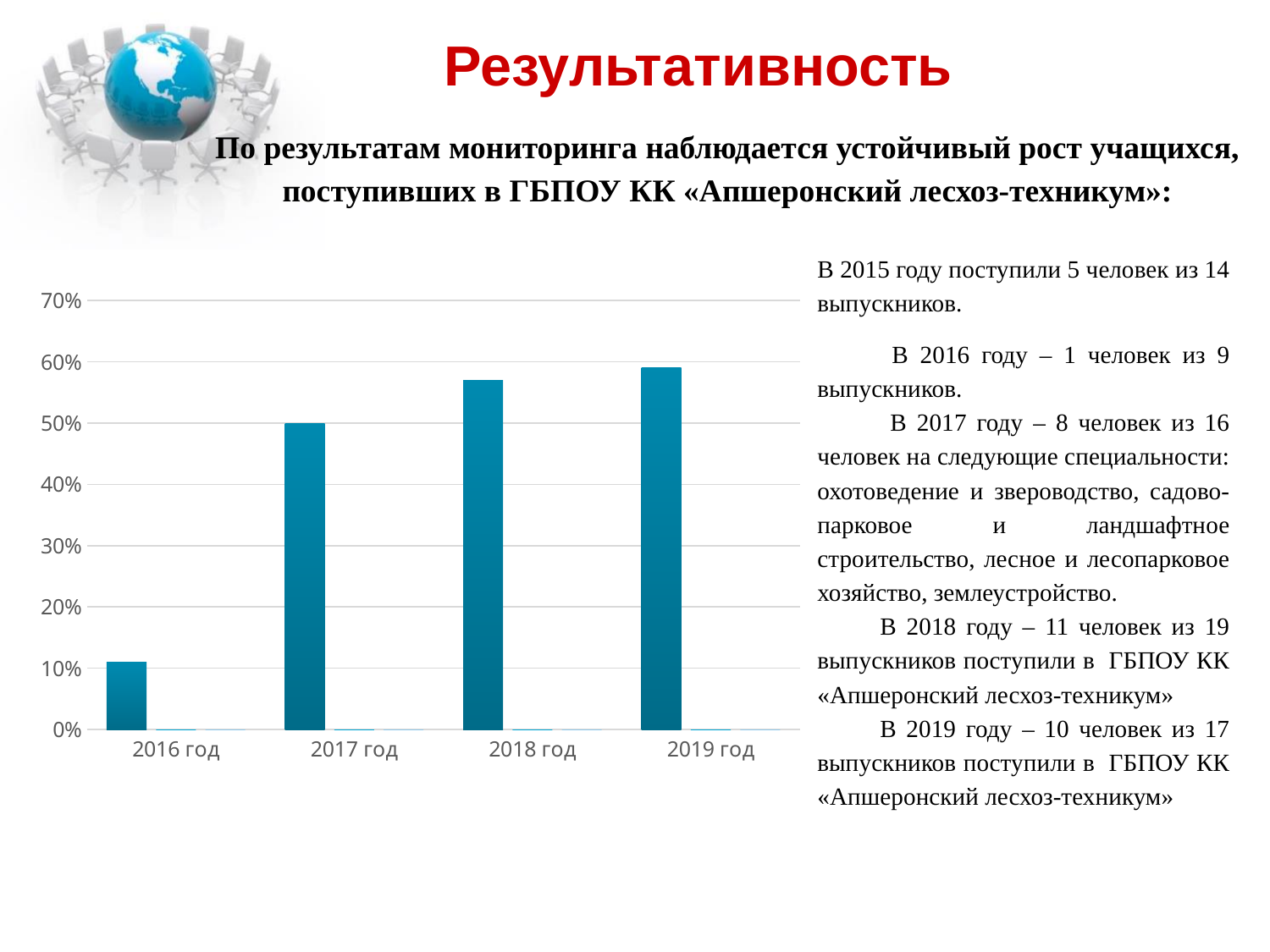
Is the value for 2016 год greater or less than 20%? less What is the value for 2017 год? 50% Which year has the highest bar in the chart? 2019 год Is the value for 2019 год greater or less than 40%? greater What kind of chart is shown on the slide? bar chart What is the highest value shown on the y axis of the chart? 70% Which is larger, the value for 2017 год or the value for 2018 год? 2018 год Which is larger, the value for 2016 год or the value for 2017 год? 2017 год Which year has the lowest bar in the chart? 2016 год How many categories (years) are shown on the x axis of the chart? 4 Is the value for 2018 год greater or less than 50%? greater Do the values rise or fall from 2016 год to 2019 год? rise